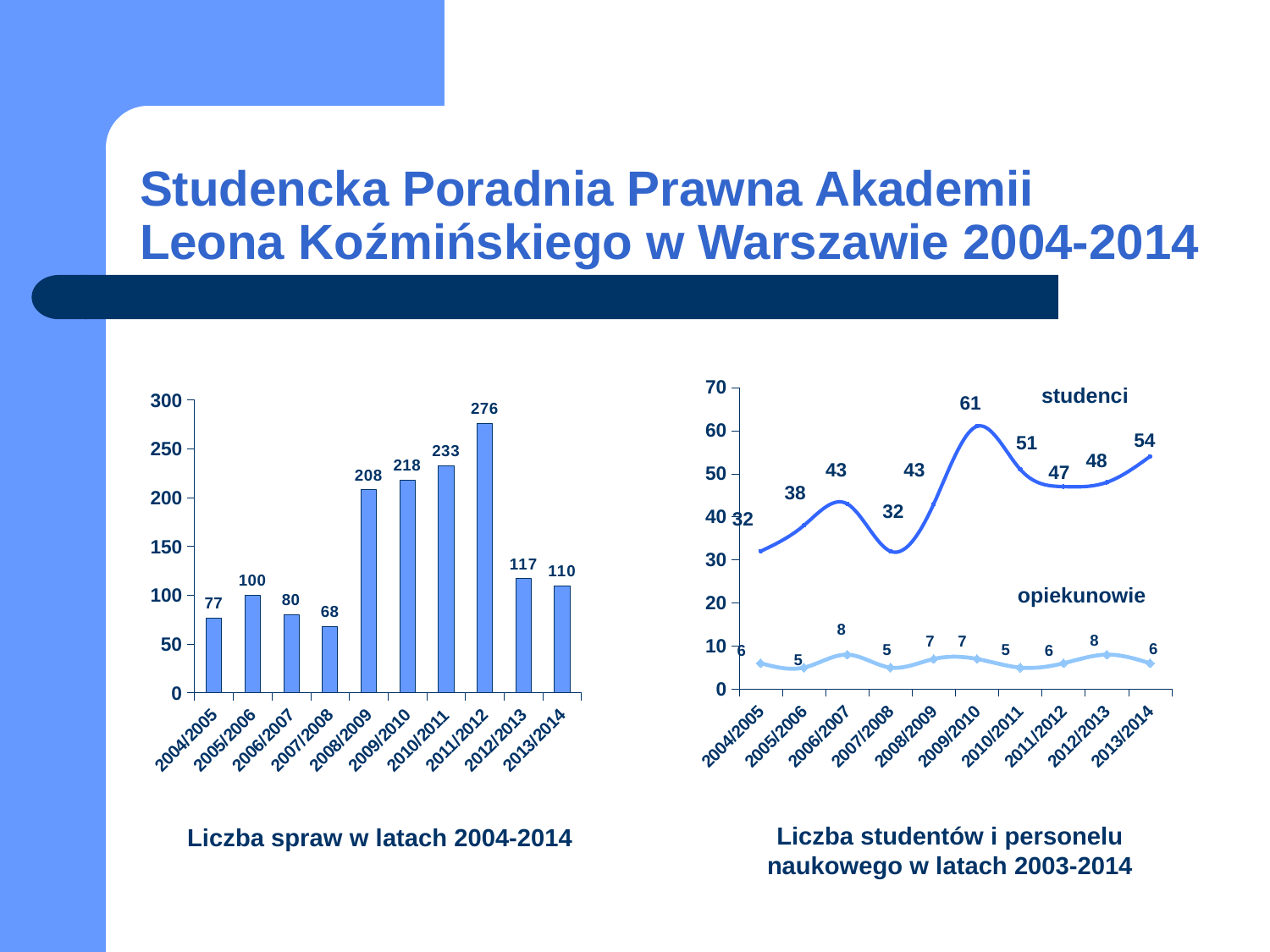
In the chart 'Liczba studentów i personelu naukowego w latach 2003-2014', how many series are plotted? 2 What kind of chart is 'Liczba spraw w latach 2004-2014'? bar chart In the chart 'Liczba spraw w latach 2004-2014', what is the value for 2011/2012? 276 In the chart 'Liczba spraw w latach 2004-2014', which year has the highest value? 2011/2012 In the chart 'Liczba studentów i personelu naukowego w latach 2003-2014', is the value for studenci in 2005/2006 larger or smaller than in 2006/2007? smaller In the chart 'Liczba spraw w latach 2004-2014', which year has the lowest value? 2007/2008 In the chart 'Liczba studentów i personelu naukowego w latach 2003-2014', which year has the highest value for studenci? 2009/2010 In the chart 'Liczba spraw w latach 2004-2014', what is the difference between the values for 2011/2012 and 2012/2013? 159 In the chart 'Liczba spraw w latach 2004-2014', how many years are shown on the x axis? 10 In the chart 'Liczba studentów i personelu naukowego w latach 2003-2014', what is the value for opiekunowie in 2006/2007? 8 In the chart 'Liczba studentów i personelu naukowego w latach 2003-2014', what is the difference between studenci and opiekunowie in 2013/2014? 48 In the chart 'Liczba studentów i personelu naukowego w latach 2003-2014', what is the value for studenci in 2009/2010? 61